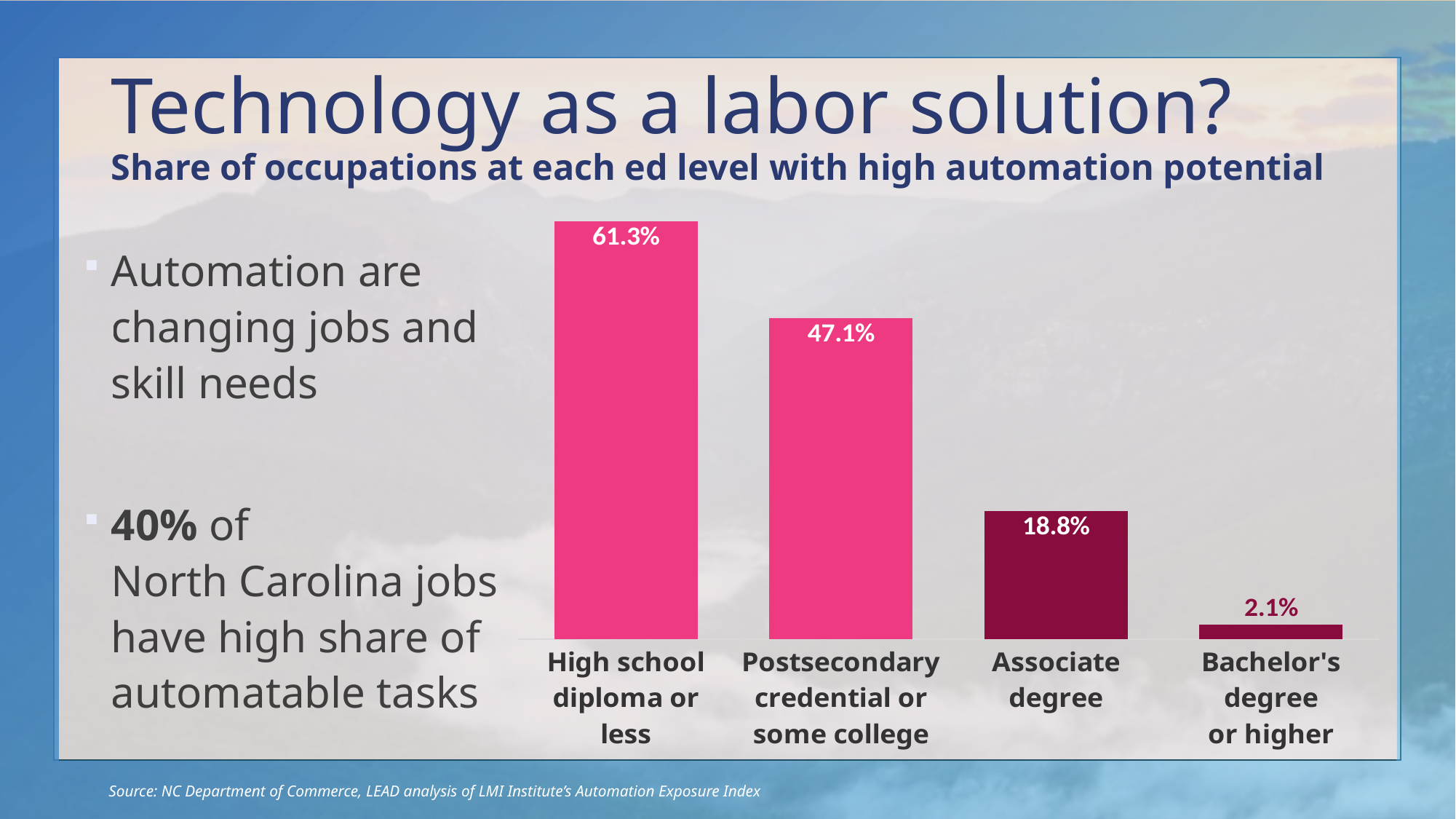
Which education level has the lowest share of occupations with high automation potential? Bachelor's degree or higher What is the value for Postsecondary credential or some college? 47.1% Do the values rise or fall moving from left to right across the education levels? Fall What is the value for Bachelor's degree or higher? 2.1% Which is larger, the value for Postsecondary credential or some college or the value for Associate degree? Postsecondary credential or some college What is the value for Associate degree? 18.8% What kind of chart is shown on the slide? Bar chart What is the share of occupations with high automation potential for High school diploma or less? 61.3% What is the difference between the values for Associate degree and Bachelor's degree or higher? 16.7% How many education levels are shown in the chart? 4 Which education level has the highest share of occupations with high automation potential? High school diploma or less What is the difference between the values for High school diploma or less and Postsecondary credential or some college? 14.2%